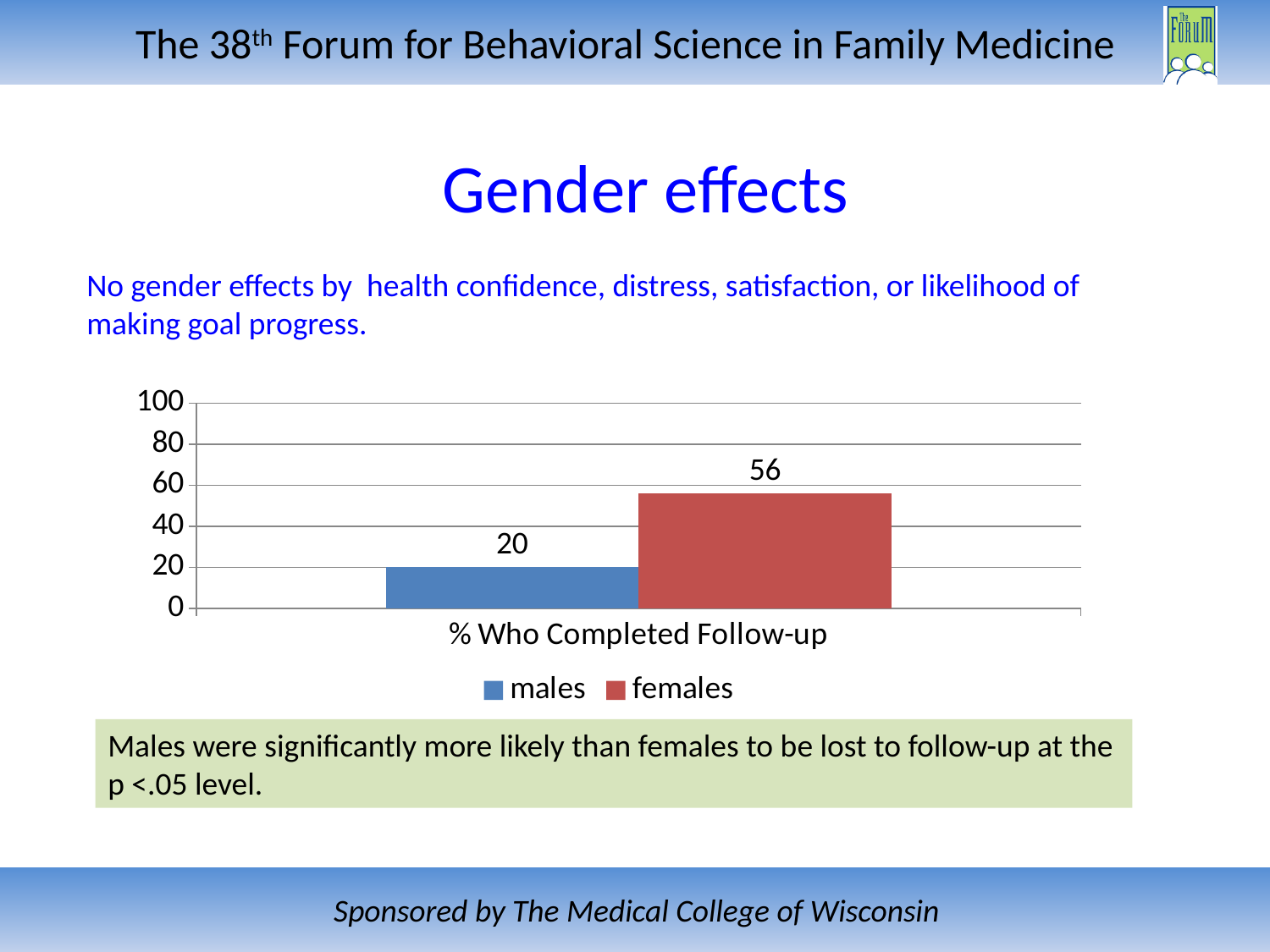
What kind of chart is shown on the slide? bar chart Which series has the higher value, males or females? females Which series has the lowest value in the chart? males Is the value for males greater or less than 40? less What is the category label shown on the x axis of the chart? % Who Completed Follow-up What is the value for females in the chart? 56 What is the difference between the values for females and males? 36 How many series does the legend list? 2 What is the value for males in the chart? 20 Is the value for females greater or less than 40? greater What is the maximum value shown on the y axis of the chart? 100 What colour are the bars for females in the chart? red